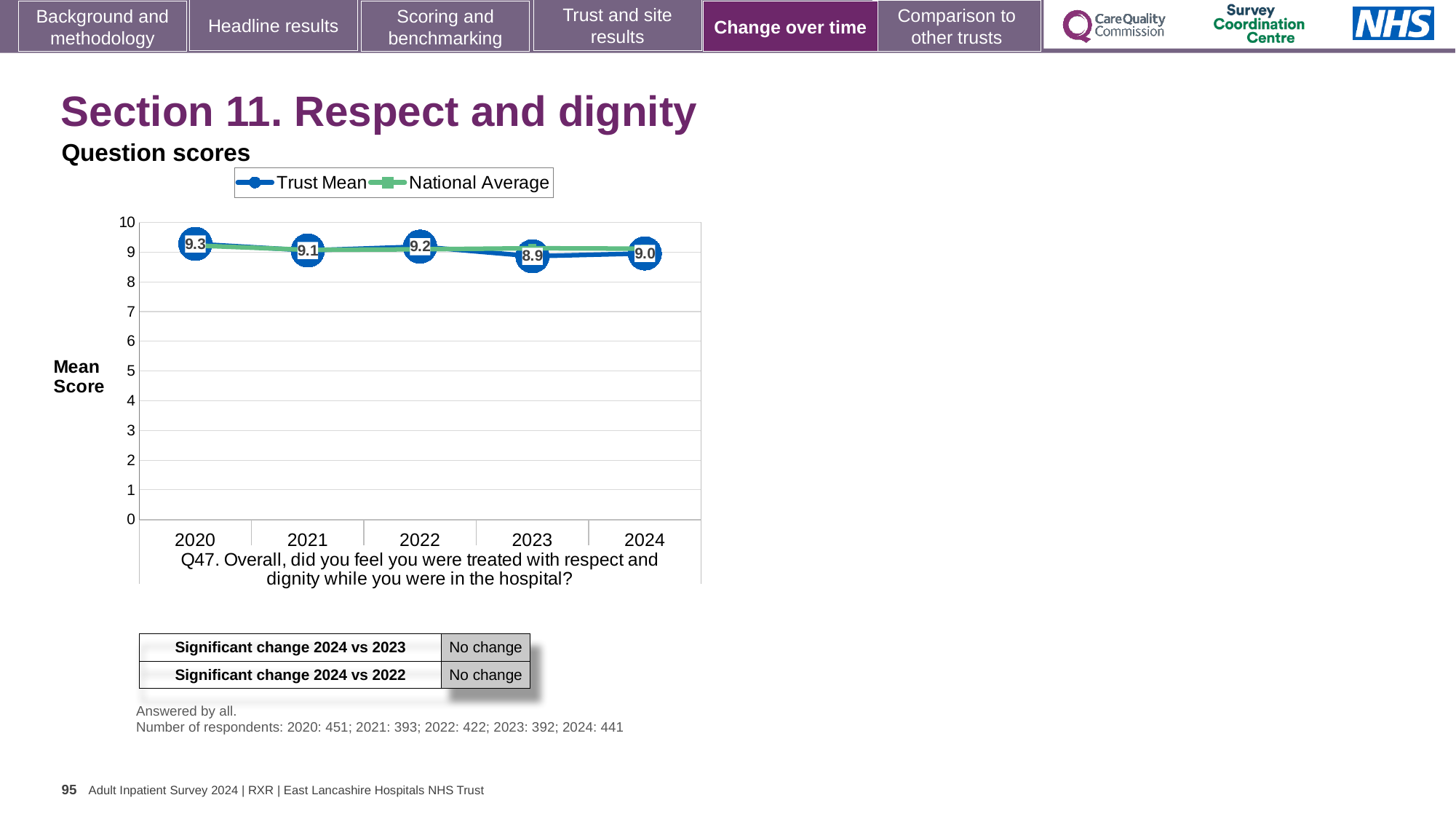
Is the National Average value for 2024 greater or less than 8? greater What is the Trust Mean score for 2020? 9.3 What kind of chart is shown on the slide? Line chart What are the two series named in the chart legend? Trust Mean and National Average How many years are shown on the x axis of the chart? 5 What is the Trust Mean score for 2023? 8.9 What is the Trust Mean score for 2024? 9.0 How many series does the chart legend list? 2 In which year was the Trust Mean score highest? 2020 Which year has the larger Trust Mean score, 2021 or 2022? 2022 What is the difference between the Trust Mean score in 2020 and in 2023? 0.4 In which year was the Trust Mean score lowest? 2023